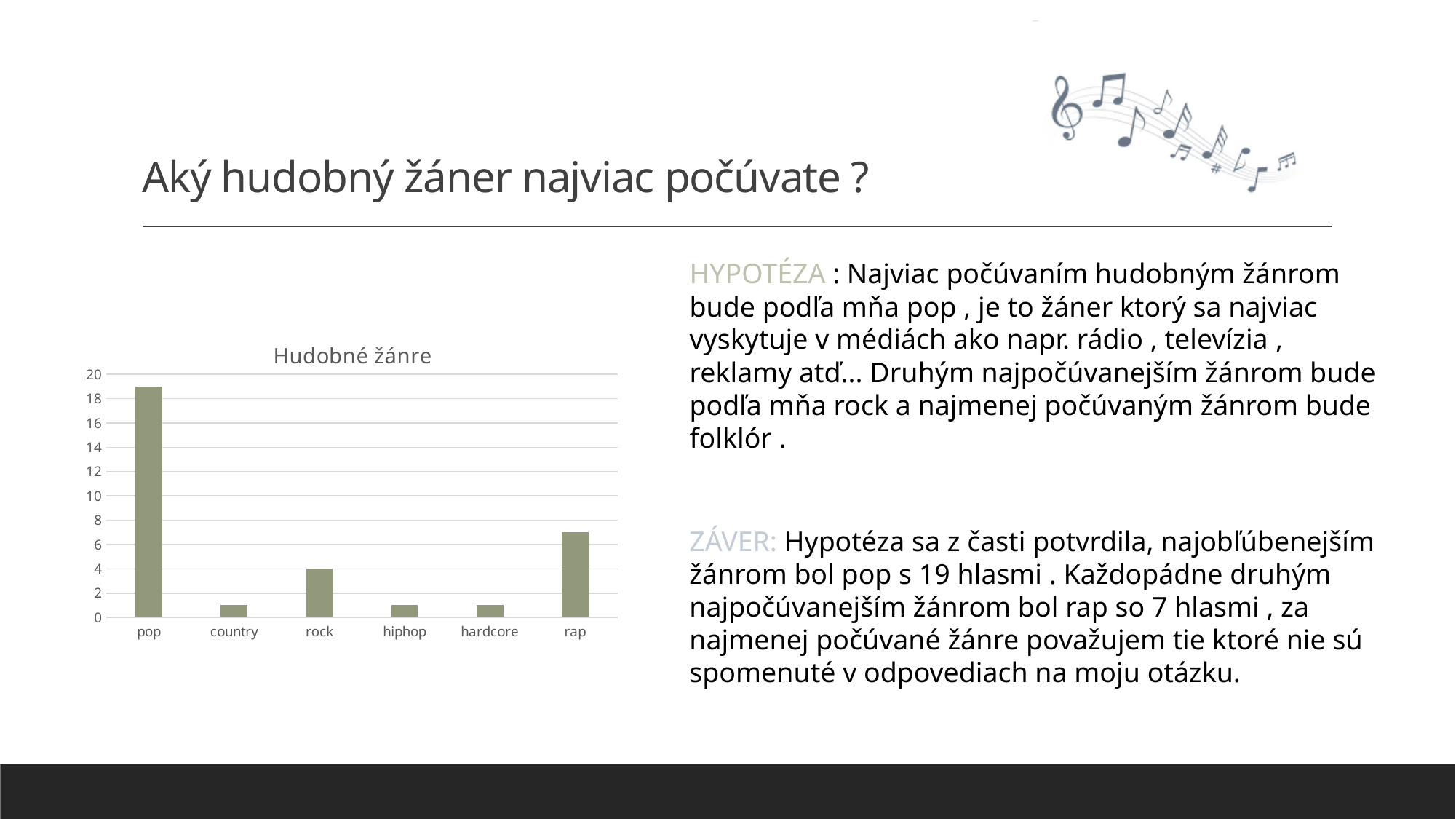
Which has a larger value, rap or rock? rap Is the value for hardcore greater or less than 2? less What is the value for rock in the chart? 4 Is the value for country greater or less than 2? less What kind of chart is shown on the slide? bar chart Is the value for pop greater or less than 18? greater What is the title of the chart? Hudobné žánre What is the value for pop in the chart? 19 What is the difference between the values for pop and rap? 12 What is the value for rap in the chart? 7 How many genres (categories) are shown on the x axis of the chart? 6 Which genre has the highest value in the chart? pop